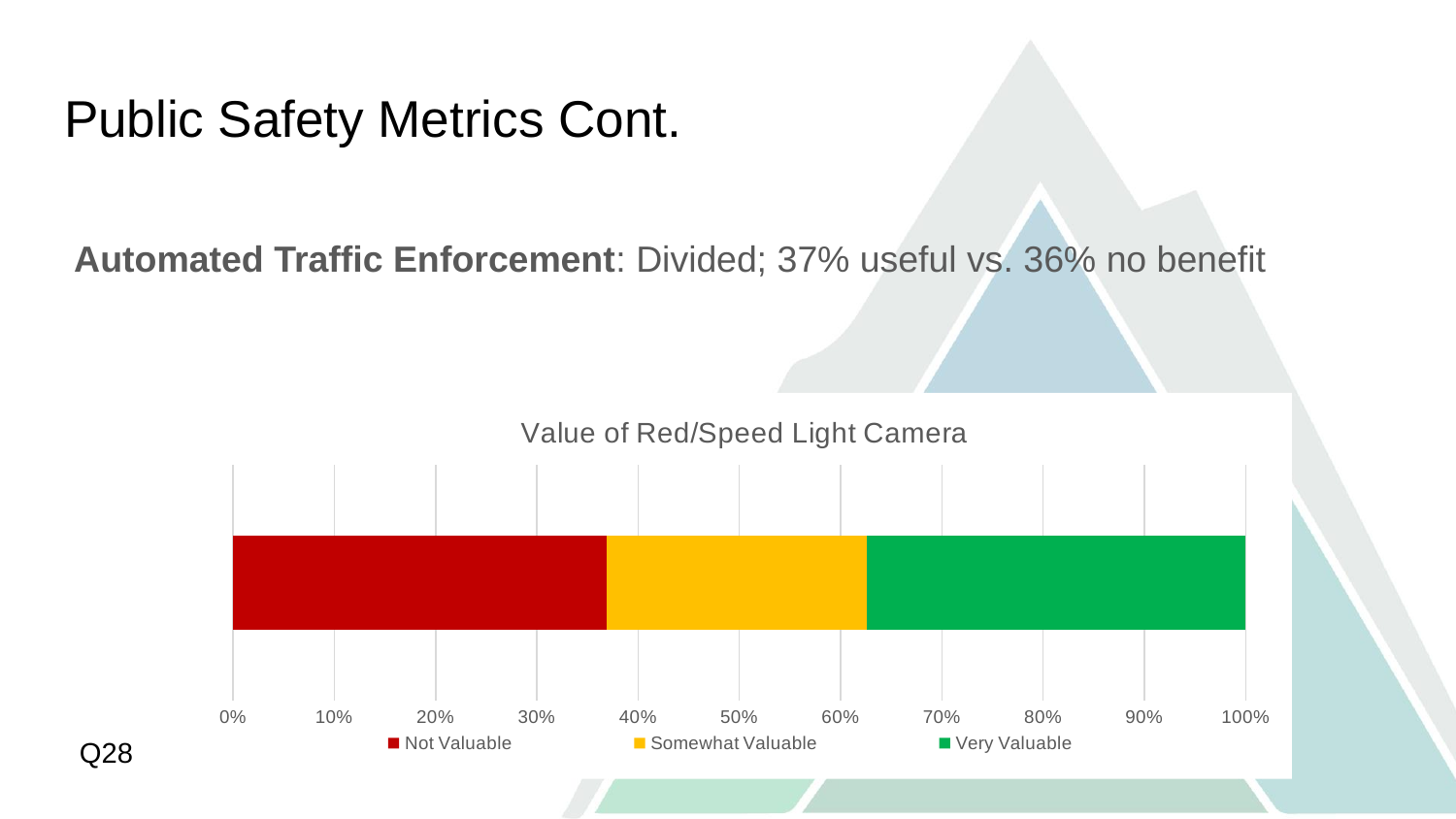
How many series does the chart legend list? 3 What is the total of the stacked bar, as shown by where it ends on the axis? 100% How many bars are plotted in the chart? 1 Is the value for Somewhat Valuable greater or less than 20%? greater What type of chart is shown on the slide? Stacked bar chart Which is larger, the Not Valuable segment or the Somewhat Valuable segment? Not Valuable Is the value for Very Valuable greater or less than 30%? greater Is the value for Not Valuable greater or less than 40%? less What is the title of the chart? Value of Red/Speed Light Camera Which series is shown in red in the chart? Not Valuable